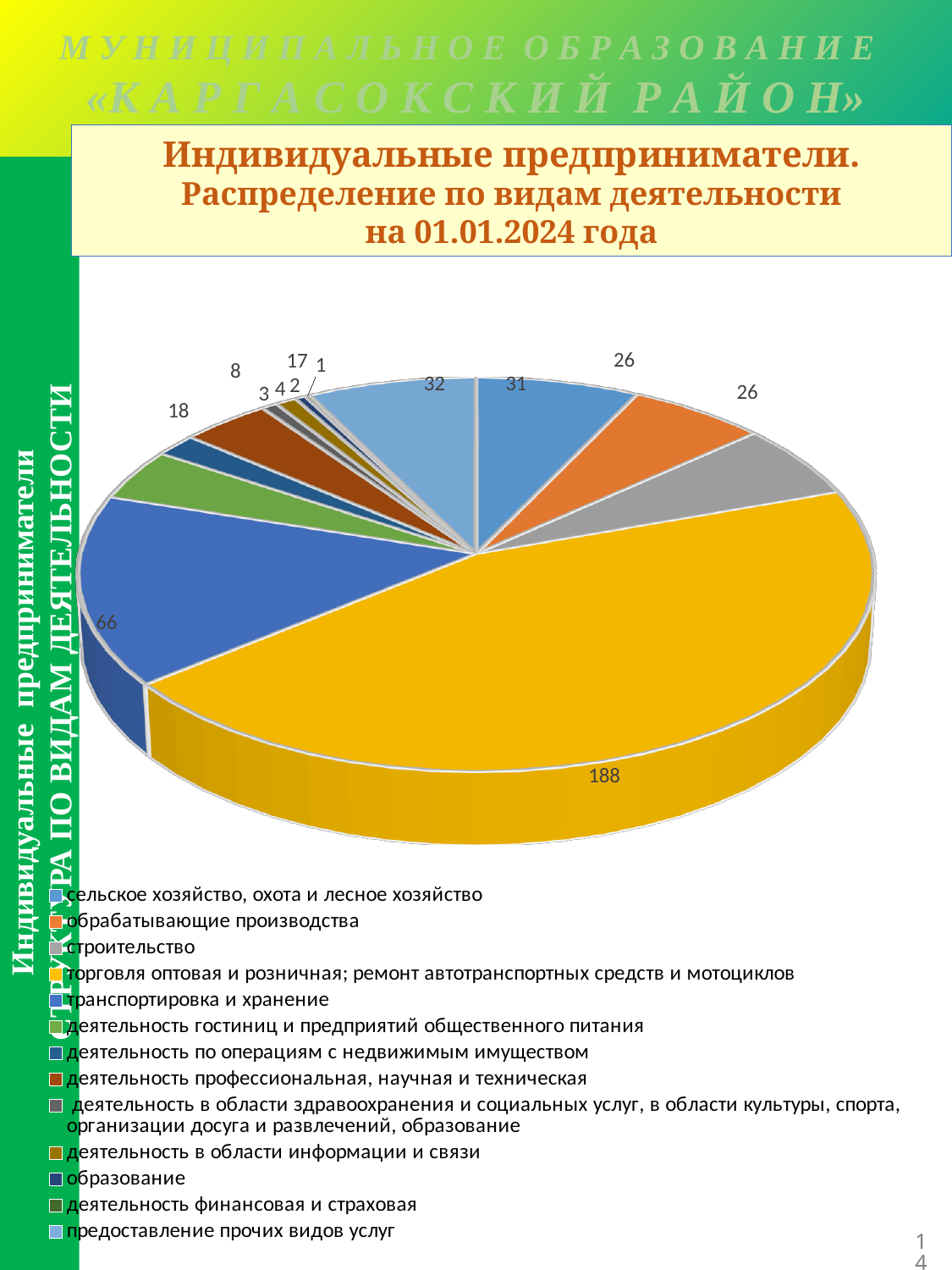
What is the value for деятельность гостиниц и предприятий общественного питания? 18 What is the value for предоставление прочих видов услуг? 32 What is the value for сельское хозяйство, охота и лесное хозяйство? 31 What kind of chart is shown on the slide? pie chart What is the value for транспортировка и хранение? 66 How many categories does the legend list? 13 What is the value for торговля оптовая и розничная; ремонт автотранспортных средств и мотоциклов? 188 What is the difference between the values for торговля оптовая и розничная and транспортировка и хранение? 122 What date is given in the chart title? 01.01.2024 Which category has the largest slice of the pie? торговля оптовая и розничная; ремонт автотранспортных средств и мотоциклов Which is larger: the value for транспортировка и хранение or the value for сельское хозяйство, охота и лесное хозяйство? транспортировка и хранение What is the smallest data label shown on the pie chart? 1